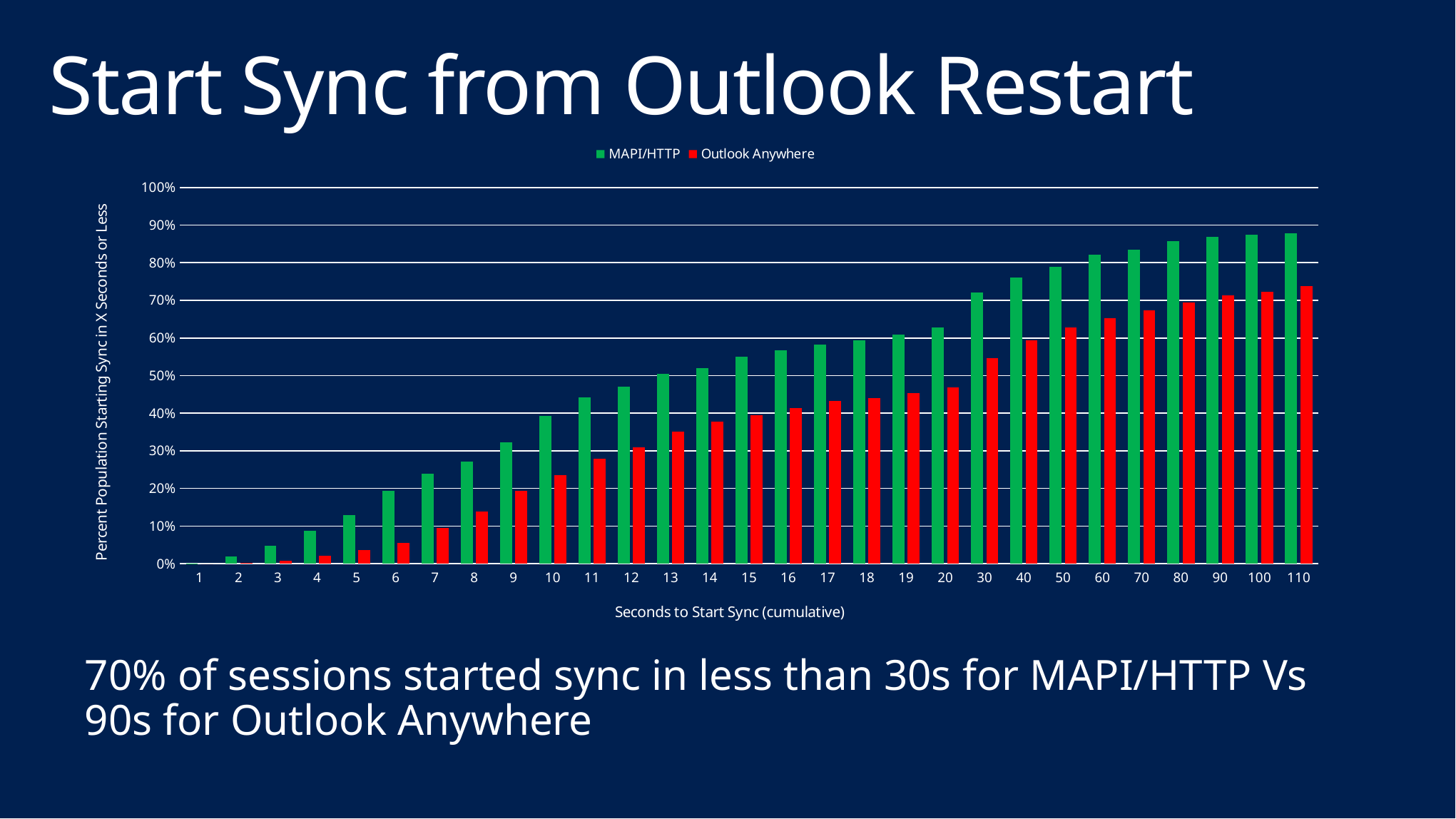
Is the MAPI/HTTP value at 10 seconds greater or less than 30%? greater Is the Outlook Anywhere value at 5 seconds greater or less than 10%? less At 15 seconds, which series has the larger value, MAPI/HTTP or Outlook Anywhere? MAPI/HTTP What is the label of the y axis? Percent Population Starting Sync in X Seconds or Less At which x-axis category does the MAPI/HTTP series reach its highest value? 110 How many categories are shown on the x axis? 29 How many series does the legend list? 2 Is the MAPI/HTTP value at 110 seconds greater or less than 80%? greater What kind of chart is shown on the slide? bar chart Do the MAPI/HTTP values rise or fall as the seconds increase along the x axis? rise